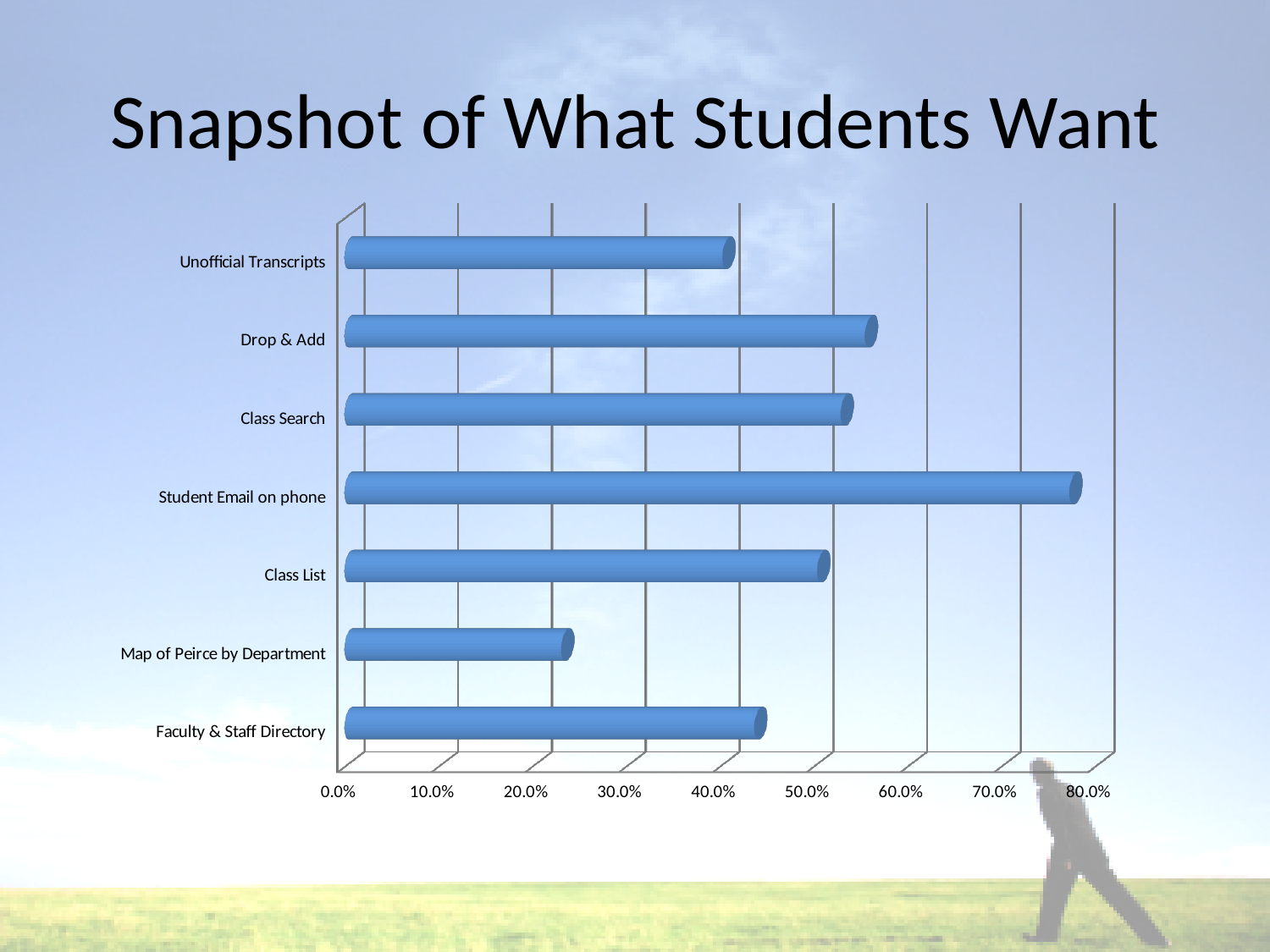
Which has a larger value, Student Email on phone or Class List? Student Email on phone Is the value for Student Email on phone greater or less than 70.0%? greater Is the value for Unofficial Transcripts greater or less than 50.0%? less What kind of chart is shown on the slide? Bar chart Which has a larger value, Map of Peirce by Department or Faculty & Staff Directory? Faculty & Staff Directory What is the title of the slide containing the chart? Snapshot of What Students Want How many categories are plotted in the chart? 7 Which category has the highest value in the chart? Student Email on phone Is the value for Drop & Add greater or less than 50.0%? greater Which category has the lowest value in the chart? Map of Peirce by Department